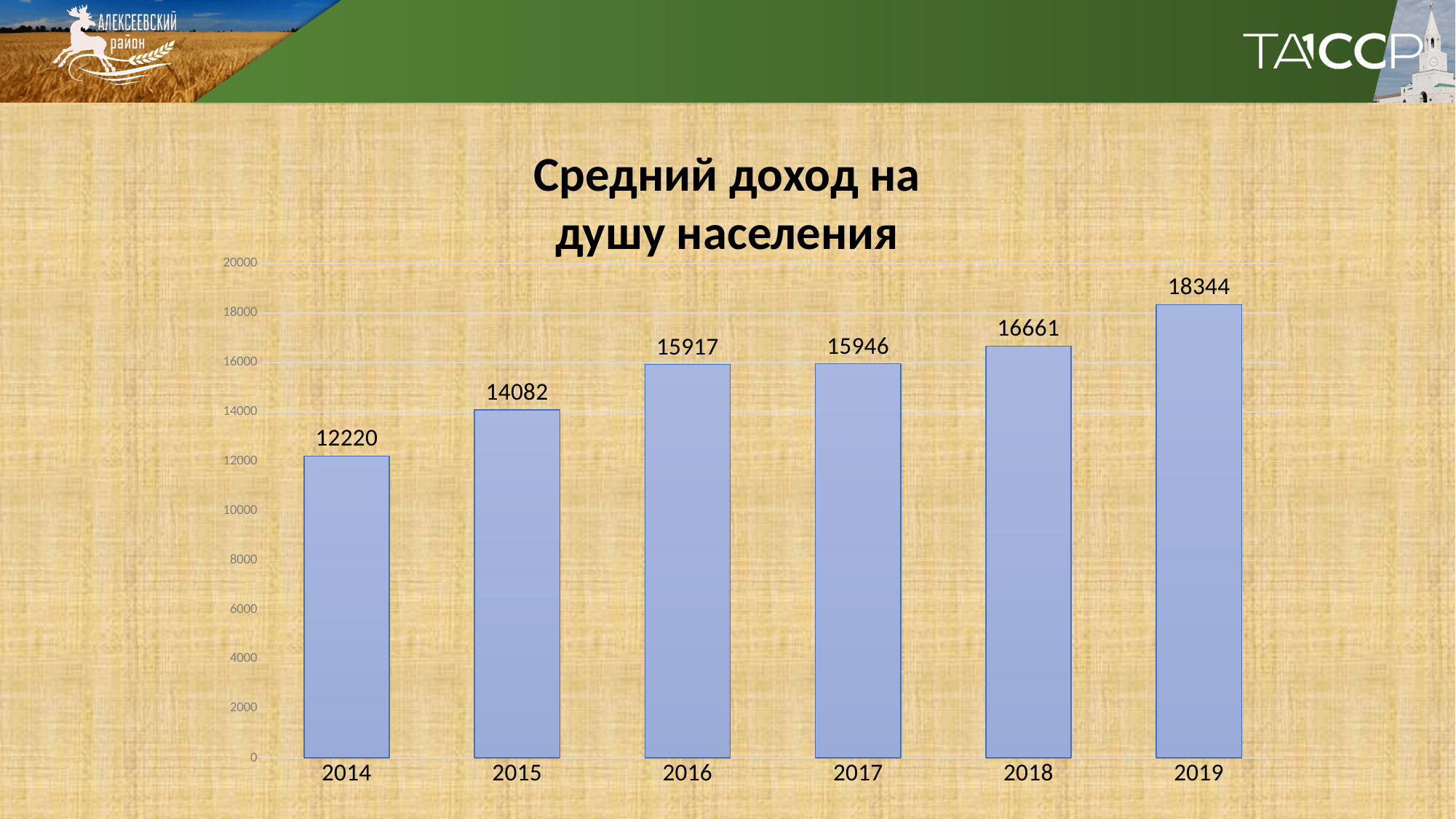
What is the value for 2014? 12220 What kind of chart is shown on the slide? bar chart Is the value for 2015 greater or less than 14000? greater What is the value for 2017? 15946 What is the difference between the values for 2019 and 2018? 1683 What is the difference between the values for 2015 and 2014? 1862 Do the values rise or fall from 2014 to 2019? rise Which year has the lowest value? 2014 Which year has the highest value? 2019 What is the value for 2019? 18344 How many years are shown on the chart? 6 Which is larger, the value for 2016 or the value for 2018? 2018